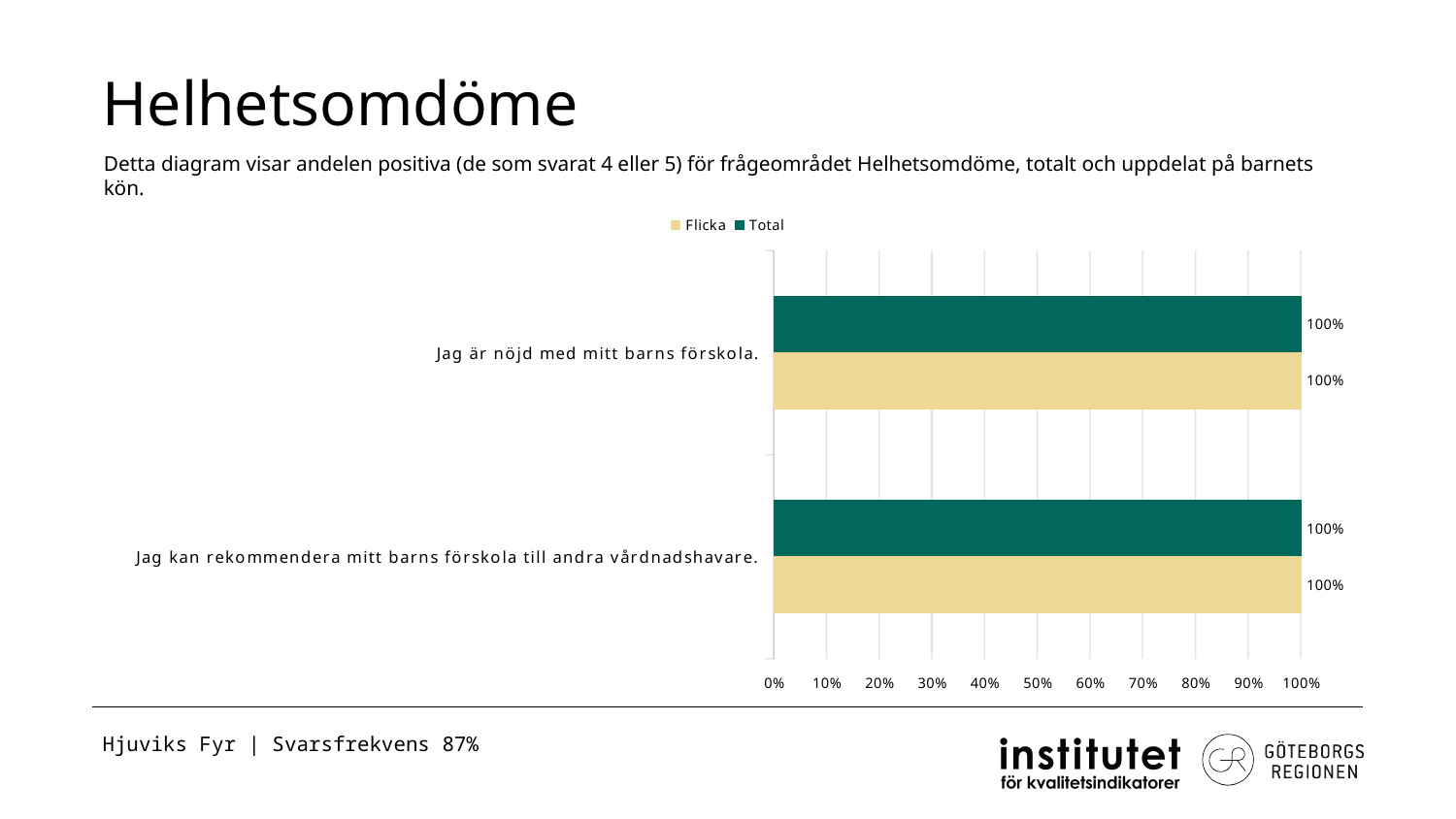
What kind of chart is shown on the slide? Bar chart What is the difference between the Flicka and Total values for "Jag är nöjd med mitt barns förskola."? 0% Is the Total value for "Jag är nöjd med mitt barns förskola." greater or less than 90%? greater How many series does the legend list? 2 Which series is shown in dark green in the chart? Total What is the value for Total for "Jag kan rekommendera mitt barns förskola till andra vårdnadshavare."? 100% What is the value for Total for "Jag är nöjd med mitt barns förskola."? 100% What is the value for Flicka for "Jag är nöjd med mitt barns förskola."? 100% What is the difference between the Flicka and Total values for "Jag kan rekommendera mitt barns förskola till andra vårdnadshavare."? 0% How many categories (statements) are shown in the chart? 2 What is the value for Flicka for "Jag kan rekommendera mitt barns förskola till andra vårdnadshavare."? 100% Is the Flicka value for "Jag kan rekommendera mitt barns förskola till andra vårdnadshavare." greater or less than 50%? greater